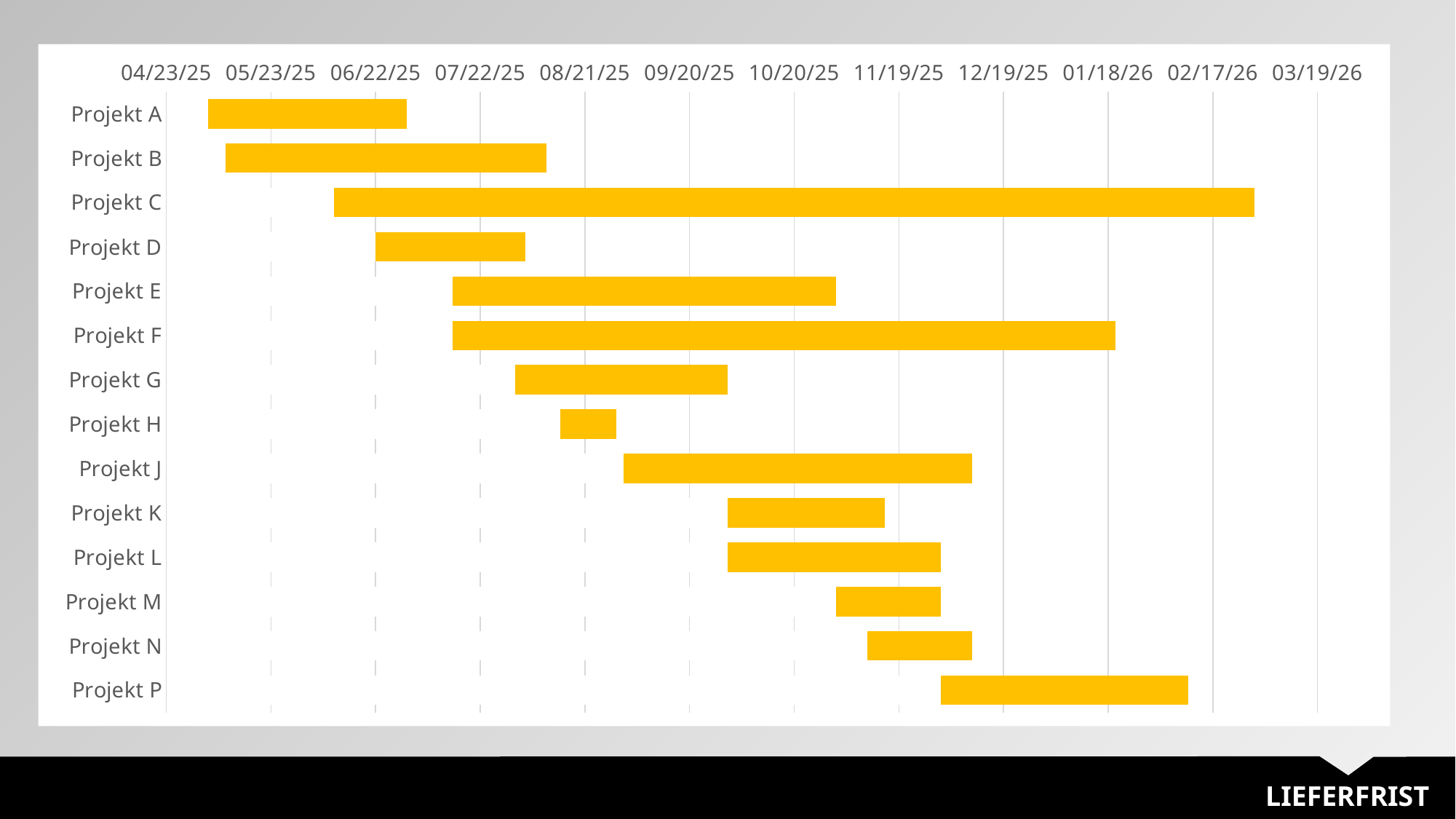
Does the bar for Projekt P start before or after 11/19/25? after Which project's bar is longer, Projekt B or Projekt A? Projekt B Does the bar for Projekt C end before or after 02/17/26? after How many projects are listed on the vertical axis of the chart? 14 What is the first date shown on the horizontal axis of the chart? 04/23/25 What kind of chart is shown on the slide? Bar chart (Gantt chart) Going down the list from Projekt A to Projekt P, do the bars generally start earlier or later on the timeline? later Does the bar for Projekt A end before or after 06/22/25? after Which project's bar starts latest on the timeline? Projekt P Which project has the shortest bar in the chart? Projekt H Which project's bar is longer, Projekt F or Projekt E? Projekt F Which project has the longest bar in the chart? Projekt C